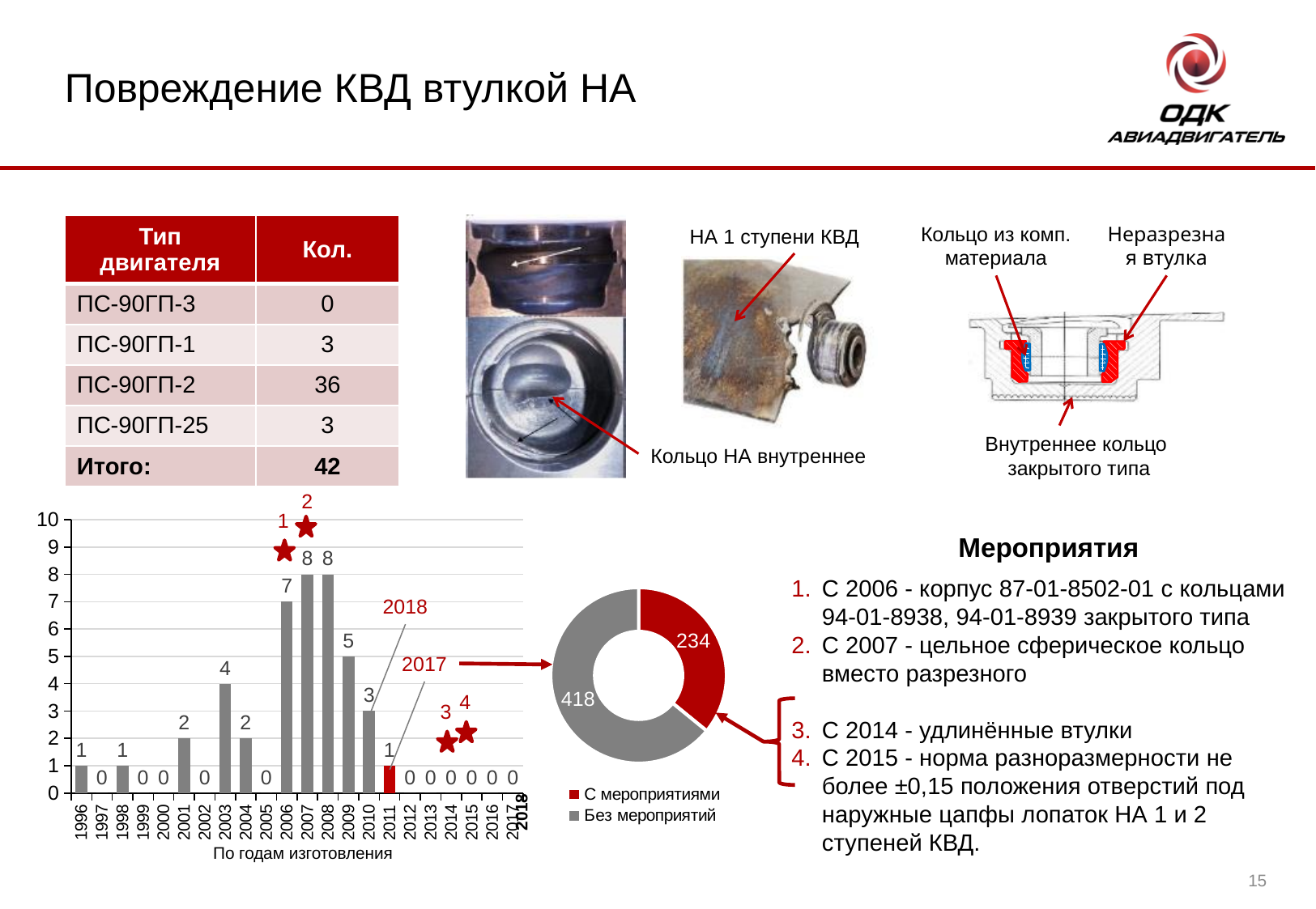
In the donut chart, what is the value for С мероприятиями? 234 In the donut chart, which category is larger, С мероприятиями or Без мероприятий? Без мероприятий How many entries does the legend of the donut chart list? 2 In the bar chart, what is the difference between the values for 2008 and 2010? 5 In the donut chart, what is the difference between Без мероприятий and С мероприятиями? 184 In the donut chart, what is the value for Без мероприятий? 418 In the bar chart, what is the value for 2011? 1 What is the x-axis title of the bar chart? По годам изготовления In the bar chart, which year has the larger value, 2003 or 2004? 2003 What kind of chart is the chart on the left with years on the x axis? bar chart In the bar chart, what is the value for 2009? 5 In the bar chart, what is the value for 2006? 7